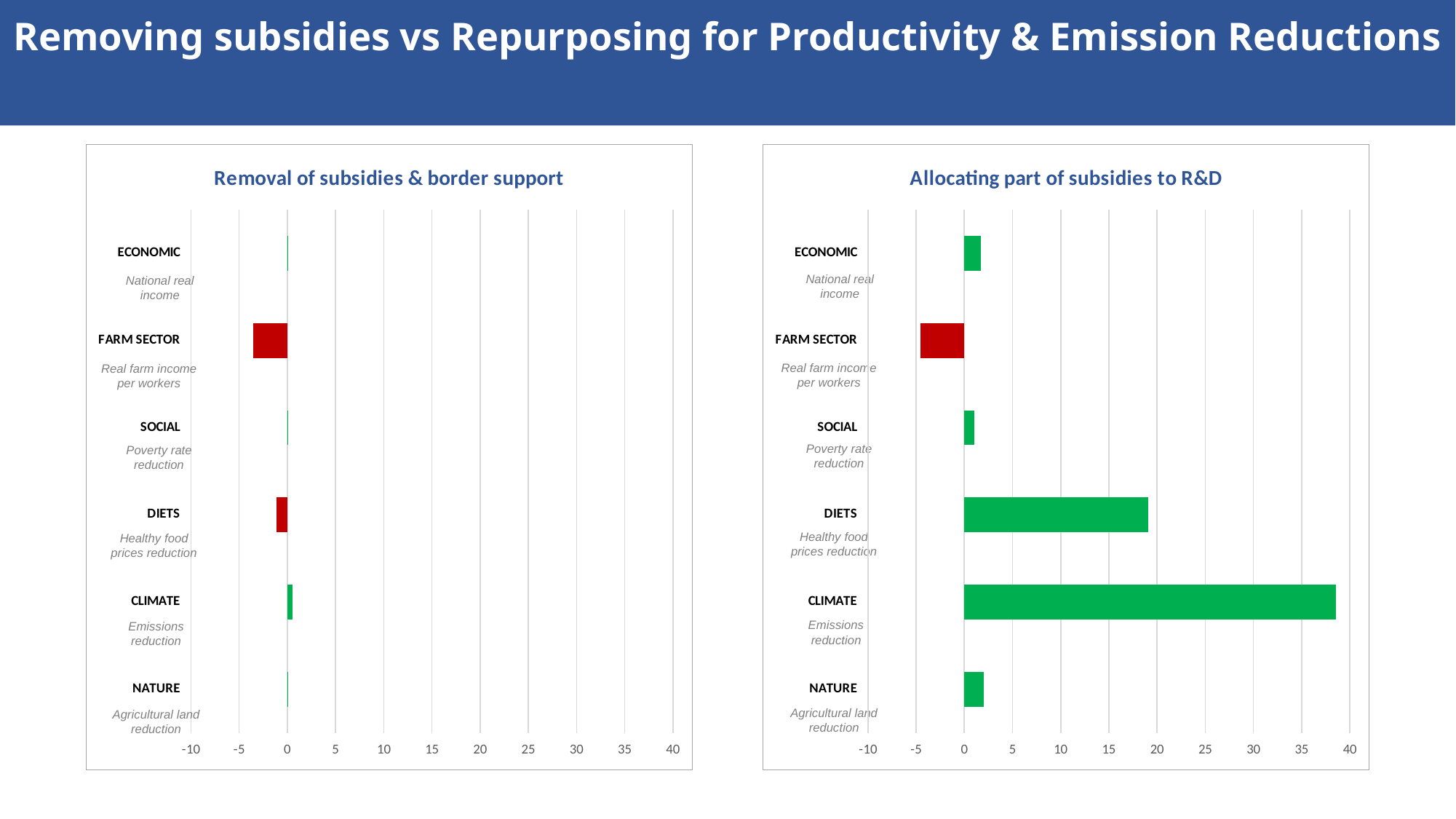
In the 'Allocating part of subsidies to R&D' chart, which category has the lowest value? FARM SECTOR In the 'Allocating part of subsidies to R&D' chart, is the value for CLIMATE greater or less than 35? greater What is the title of the chart on the left side of the slide? Removal of subsidies & border support In the 'Removal of subsidies & border support' chart, which category has the lowest value? FARM SECTOR What kind of chart is the 'Allocating part of subsidies to R&D' chart? bar chart In the 'Allocating part of subsidies to R&D' chart, is the value for FARM SECTOR greater or less than 0? less In the 'Removal of subsidies & border support' chart, which is larger, the value for CLIMATE or the value for FARM SECTOR? CLIMATE In the 'Allocating part of subsidies to R&D' chart, what colour is the bar for FARM SECTOR? red How many categories are shown in the 'Removal of subsidies & border support' chart? 6 In the 'Allocating part of subsidies to R&D' chart, which is larger, the value for DIETS or the value for NATURE? DIETS In the 'Allocating part of subsidies to R&D' chart, which category has the highest value? CLIMATE In the 'Allocating part of subsidies to R&D' chart, is the value for DIETS greater or less than 15? greater